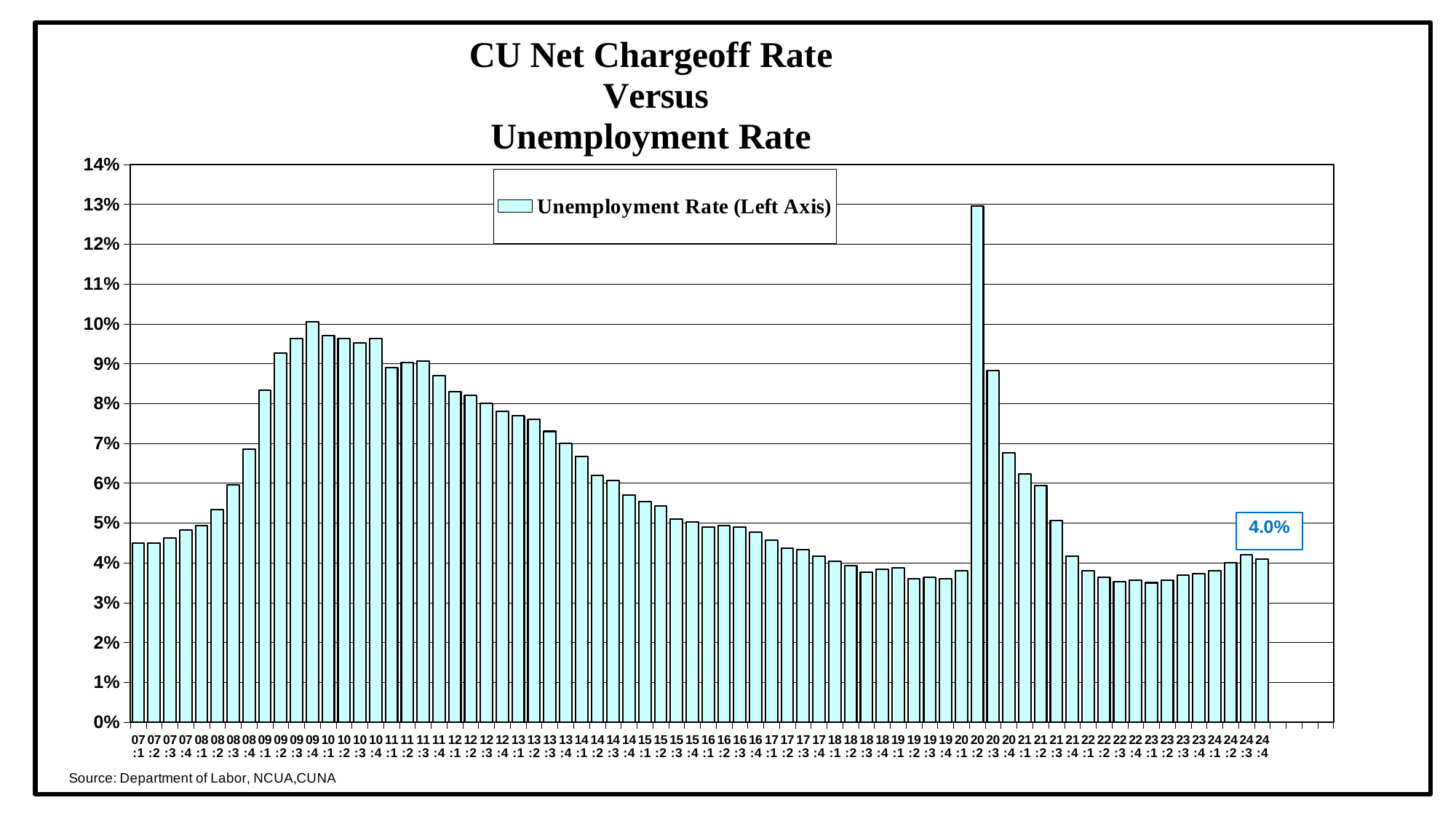
Which quarter has the highest unemployment rate in the chart? 20:2 How many quarterly bars are plotted in the chart? 72 Does the unemployment rate rise or fall from 09:4 to 19:4? fall What kind of chart is shown on the slide? Bar chart Is the unemployment rate for 20:2 greater or less than 12%? greater What is the title of the chart? CU Net Chargeoff Rate Versus Unemployment Rate How many series does the legend list? 1 Is the unemployment rate for 09:4 greater or less than 9%? greater Is the unemployment rate for 18:3 greater or less than 4%? less Which quarter has the higher unemployment rate, 20:2 or 09:4? 20:2 What is the unemployment rate shown by the data label on the last bar (24:4)? 4.0%